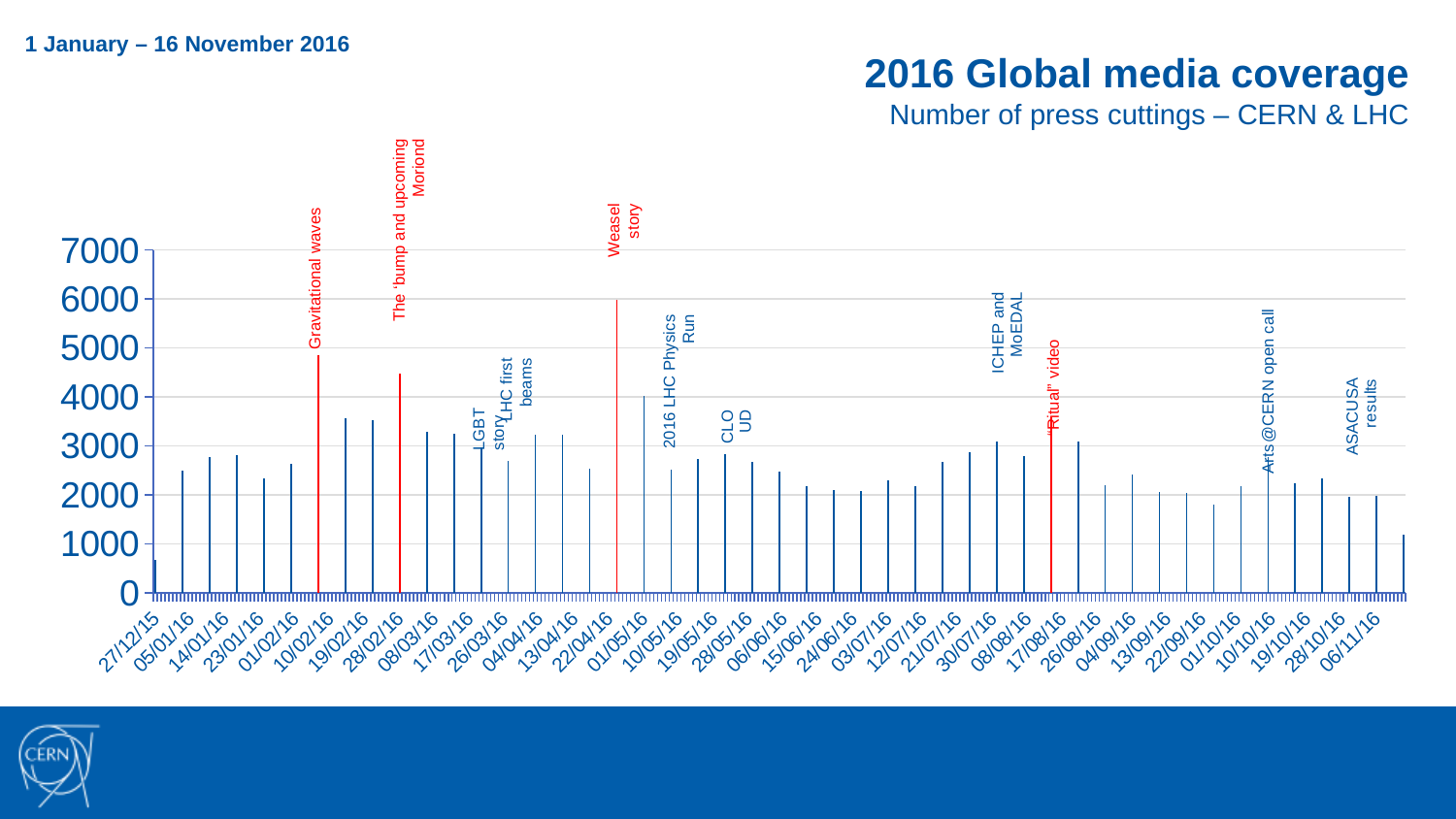
Is the value for the bar annotated 'ASACUSA results' greater or less than 3000? less Is the value for the first bar (27/12/15) greater or less than 1000? less Which annotated event has the highest bar on the chart? Weasel story Which bar is taller: the one annotated 'Gravitational waves' or the one annotated '"Ritual" video'? Gravitational waves Is the value for the bar annotated 'Weasel story' greater or less than 5000? greater What kind of chart is shown on the slide? bar chart What is the title of the chart? 2016 Global media coverage Which bar is taller: the one annotated 'Weasel story' or the one annotated 'The ‘bump and upcoming Moriond'? Weasel story What does the subtitle say the chart counts? Number of press cuttings – CERN & LHC What is the highest value shown on the vertical axis? 7000